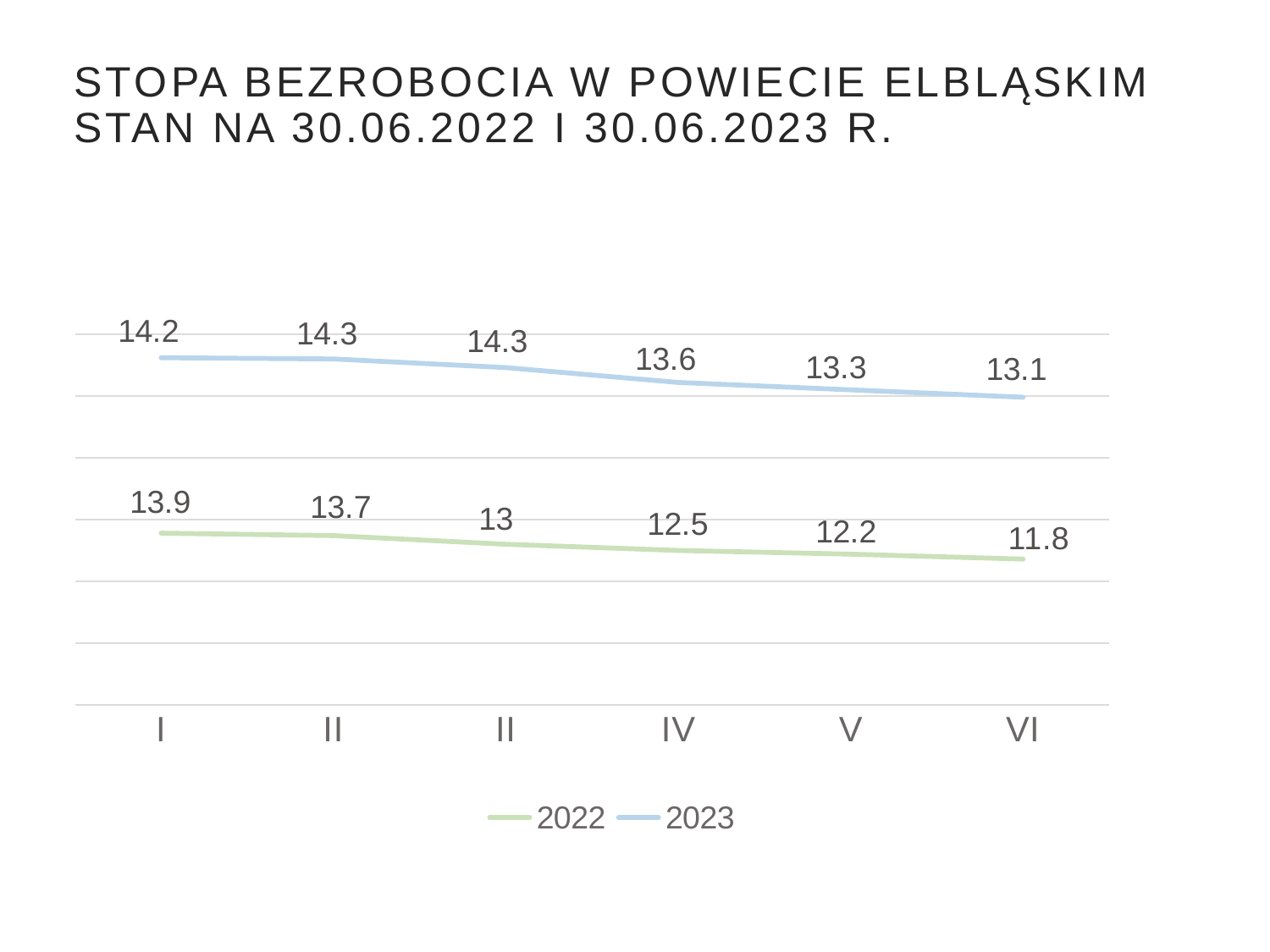
Which series has the higher value at category IV, 2022 or 2023? 2023 How many data points does each series have? 6 What is the difference between the 2023 and 2022 values at category VI? 1.3 At which category is the 2023 series lowest? VI What is the value for the 2023 series at category V? 13.3 What is the value for the 2023 series at category I? 14.2 At which category is the 2022 series lowest? VI Do the values of the 2022 series rise or fall from category I to category VI? fall How many series does the legend list? 2 What is the value for the 2022 series at category IV? 12.5 What kind of chart is shown on the slide? line chart What is the value for the 2022 series at category VI? 11.8